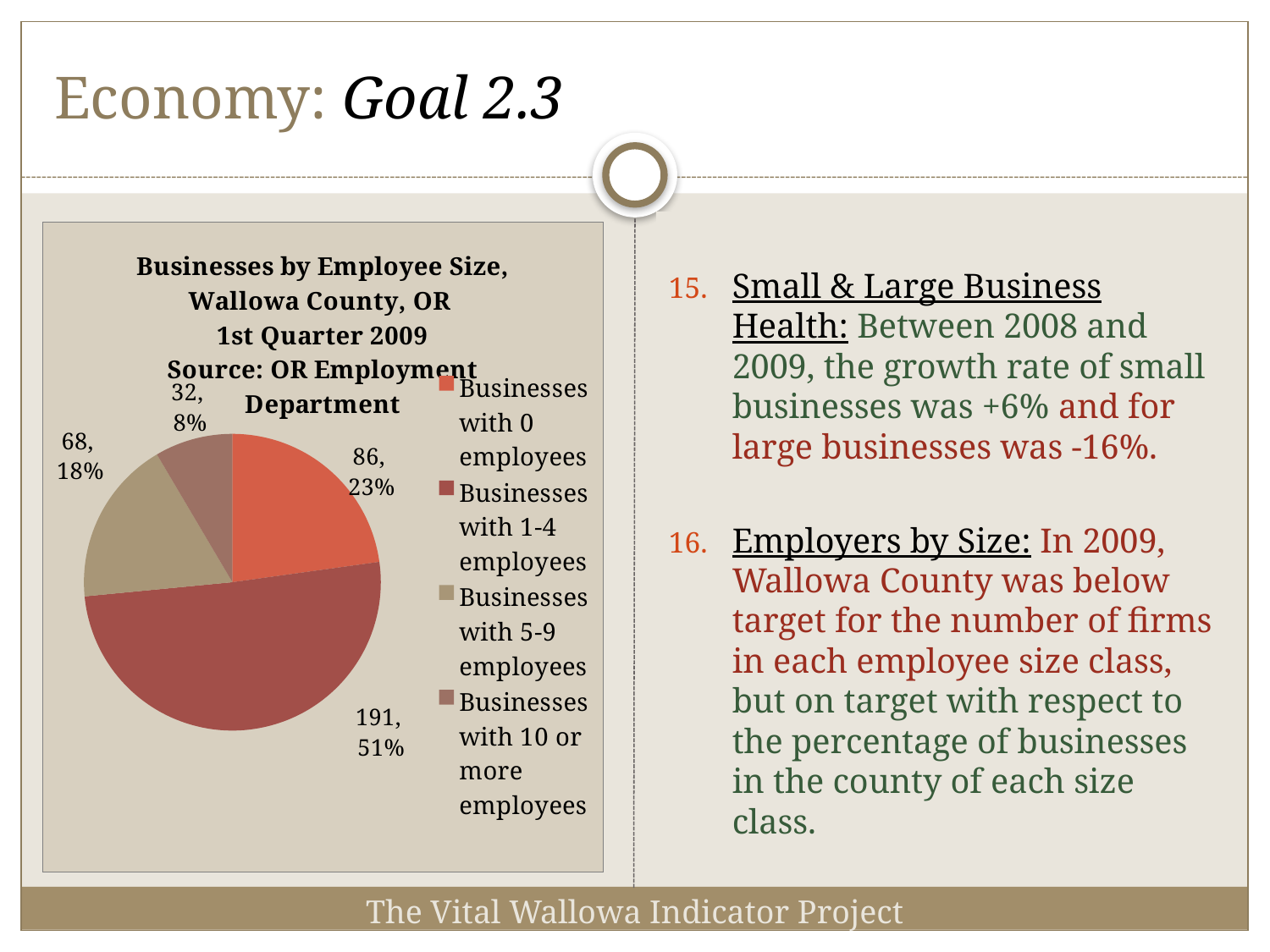
According to the chart title, what is the source of the data? OR Employment Department What is the difference between the number of businesses with 1-4 employees and the number with 0 employees? 105 What percentage of businesses have 0 employees according to the pie chart? 23% Which employee size class has the smallest slice of the pie? Businesses with 10 or more employees What is the total number of businesses represented in the pie chart? 377 How many businesses with 1-4 employees are shown in the pie chart? 191 Which is larger: the number of businesses with 5-9 employees or the number with 10 or more employees? Businesses with 5-9 employees Which employee size class has the largest slice of the pie? Businesses with 1-4 employees How many employee size classes does the pie chart show? 4 What type of chart is shown on the slide? Pie chart How many businesses with 10 or more employees are shown in the pie chart? 32 What share of the pie is taken by businesses with 5-9 employees? 18%